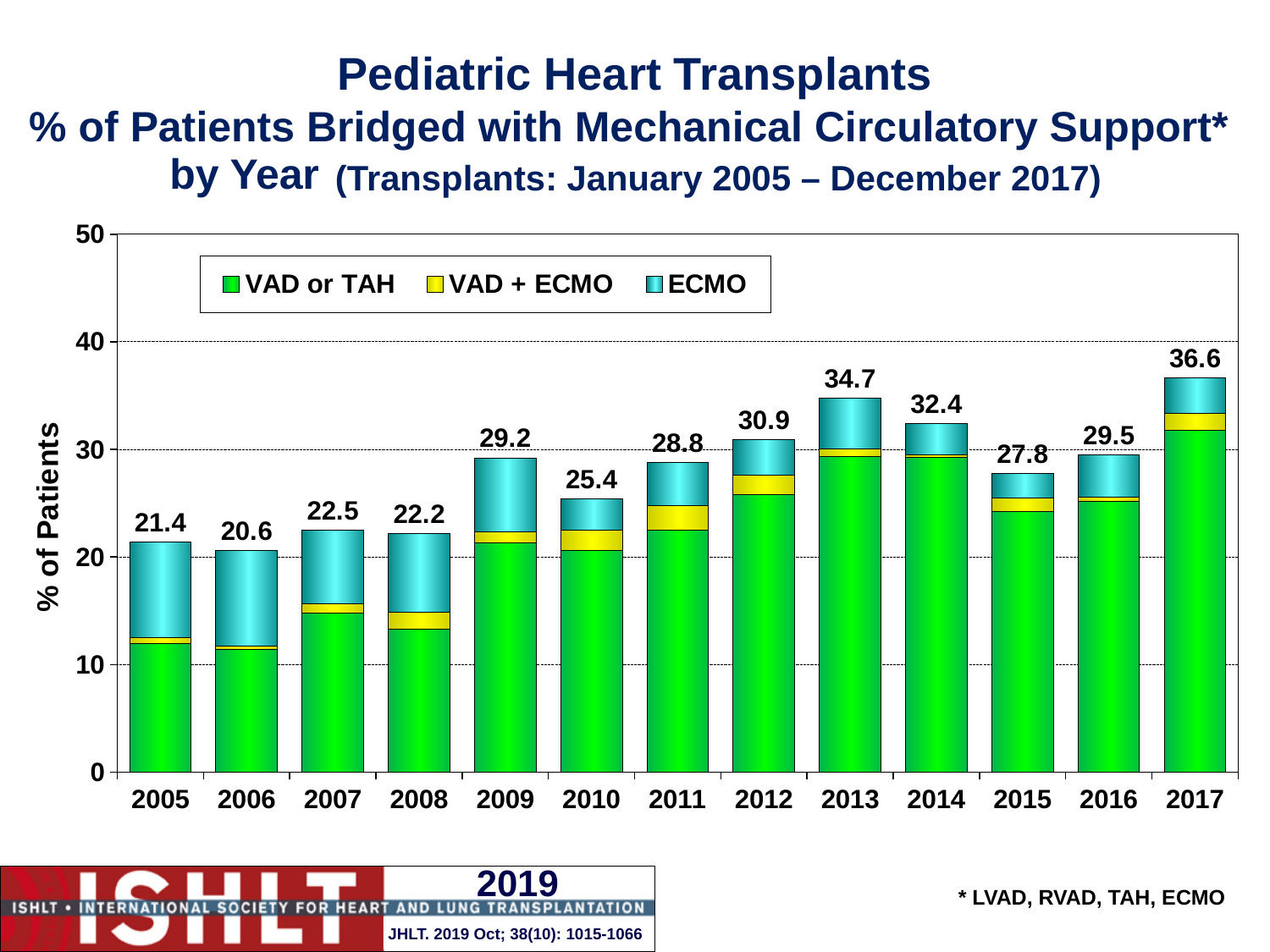
What is the total percentage of patients bridged with mechanical circulatory support in 2013? 34.7 What is the difference between the total percentage in 2017 and the total percentage in 2013? 1.9 Which year has a larger total percentage, 2012 or 2014? 2014 Is the VAD or TAH value for 2006 greater or less than 20? less What kind of chart is shown on the slide? Stacked bar chart What is the total percentage of patients bridged with mechanical circulatory support in 2005? 21.4 Which year has the highest total percentage of patients bridged with mechanical circulatory support? 2017 How many series does the legend list? 3 Is the VAD or TAH value for 2017 greater or less than 30? greater Which year has the lowest total percentage of patients bridged with mechanical circulatory support? 2006 What is the difference between the total percentage in 2009 and the total percentage in 2008? 7.0 How many years are shown on the x axis of the chart? 13